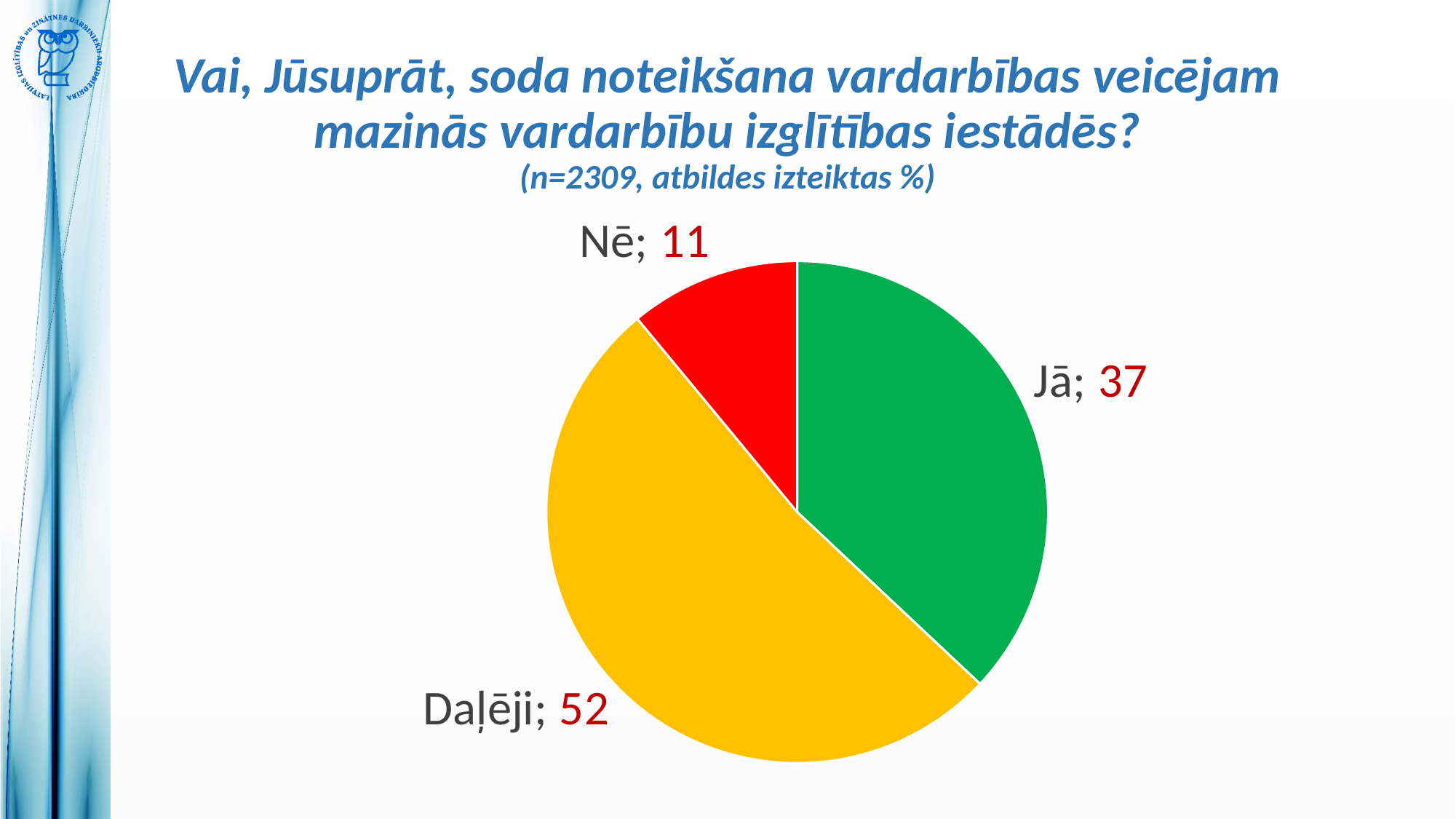
What is the value for "Daļēji"? 52 What is the value for "Nē"? 11 What is the value for "Jā"? 37 Which category has the smallest slice? Nē What is the difference between the values for "Jā" and "Nē"? 26 Which category has the largest slice? Daļēji What is the difference between the values for "Daļēji" and "Jā"? 15 What type of chart is shown on the slide? pie chart What colour is the "Daļēji" slice? yellow How many slices does the pie chart have? 3 What is the sample size (n) stated in the chart subtitle? 2309 Which is larger, the value for "Jā" or the value for "Nē"? Jā